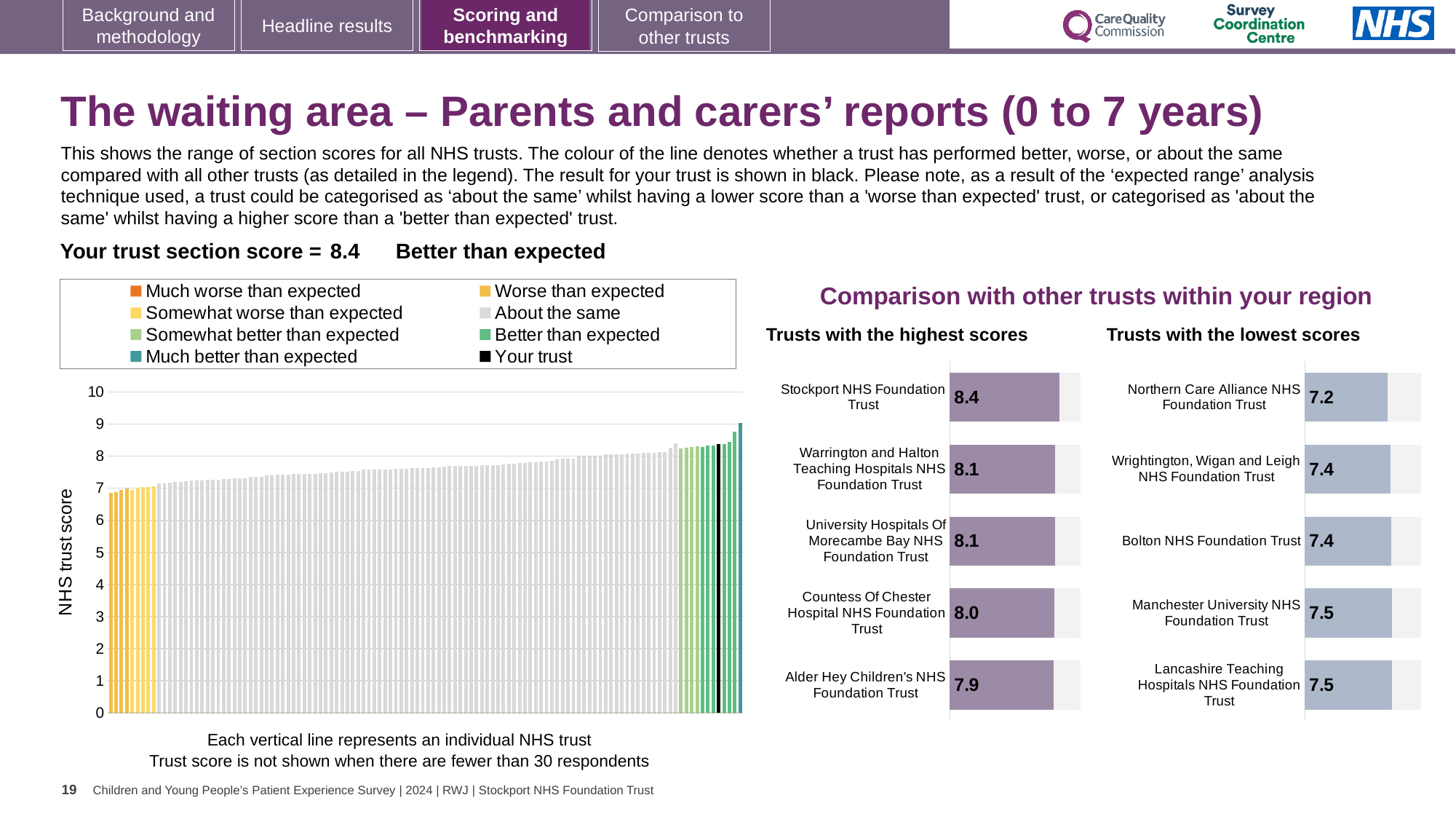
In the 'Trusts with the highest scores' chart, which trust has the lowest score? Alder Hey Children's NHS Foundation Trust In the 'Trusts with the lowest scores' chart, which has the higher score: Bolton NHS Foundation Trust or Manchester University NHS Foundation Trust? Manchester University NHS Foundation Trust In the 'Trusts with the lowest scores' chart, what is the score for Bolton NHS Foundation Trust? 7.4 How many entries does the legend above the main 'NHS trust score' chart list? 8 In the 'Trusts with the highest scores' chart, what is the difference between the scores of Stockport NHS Foundation Trust and Alder Hey Children's NHS Foundation Trust? 0.5 In the 'Trusts with the highest scores' chart, what is the score for Stockport NHS Foundation Trust? 8.4 In the main 'NHS trust score' chart on the left, do the bar values rise or fall from left to right? rise How many trusts are listed in the 'Trusts with the highest scores' chart? 5 In the 'Trusts with the lowest scores' chart, what is the difference between the scores of Lancashire Teaching Hospitals NHS Foundation Trust and Northern Care Alliance NHS Foundation Trust? 0.3 What kind of chart is the main 'NHS trust score' chart on the left? bar chart In the main 'NHS trust score' chart on the left, is the value for the black 'Your trust' bar greater or less than 8? greater In the 'Trusts with the lowest scores' chart, which trust has the lowest score? Northern Care Alliance NHS Foundation Trust